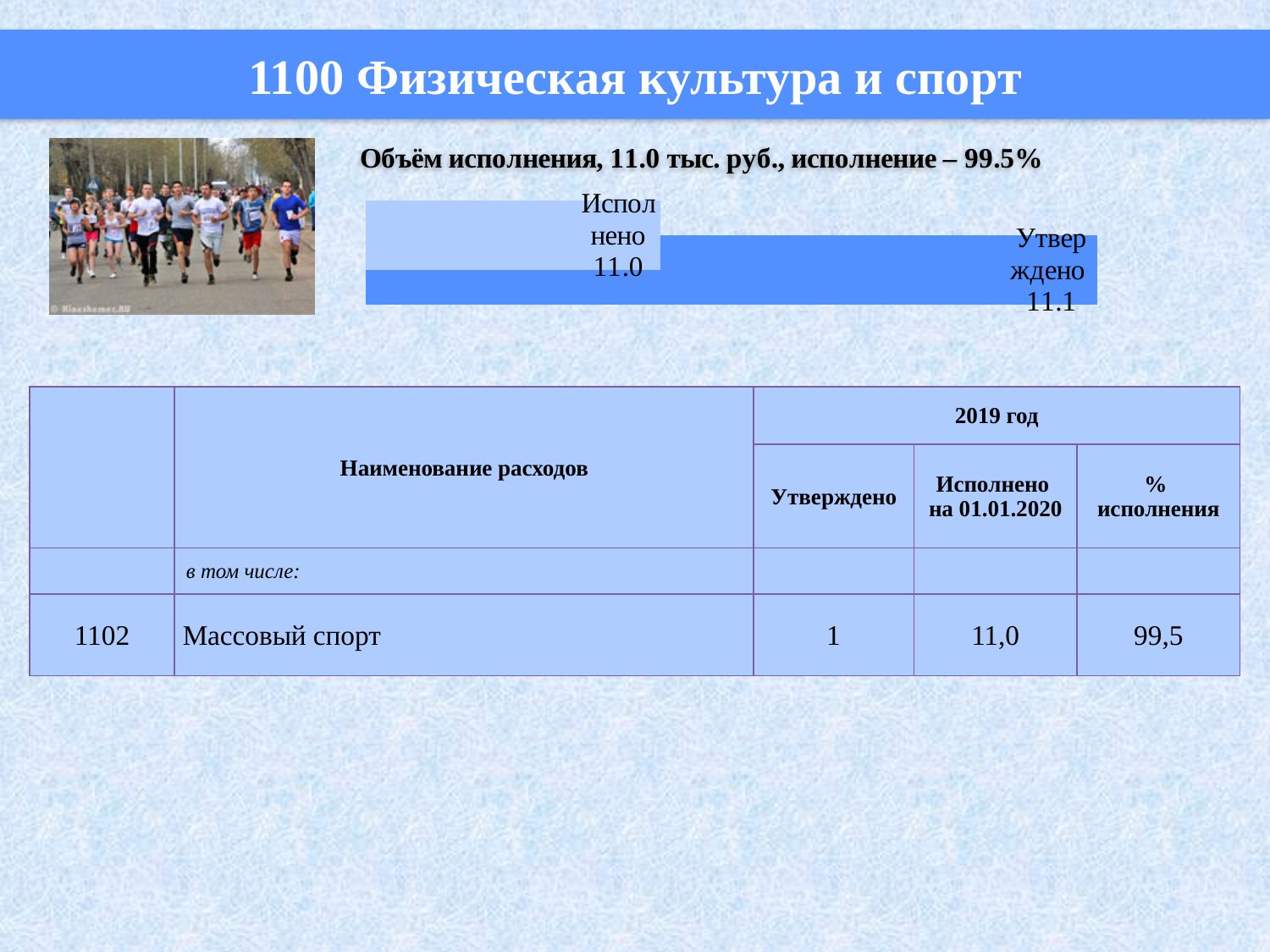
Which bar in the chart has the higher value? Утверждено What is the difference between the Утверждено and Исполнено values in the bar chart? 0.1 How many bars are plotted in the chart? 2 What is the text written above the bar chart? Объём исполнения, 11.0 тыс. руб., исполнение – 99.5% Which bar in the chart has the lower value? Исполнено What kind of chart is shown on the slide? bar chart What is the value shown for Исполнено in the bar chart? 11.0 Is the value for Утверждено larger or smaller than the value for Исполнено? larger What is the value shown for Утверждено in the bar chart? 11.1 Which bar in the chart is drawn in the lighter blue colour? Исполнено